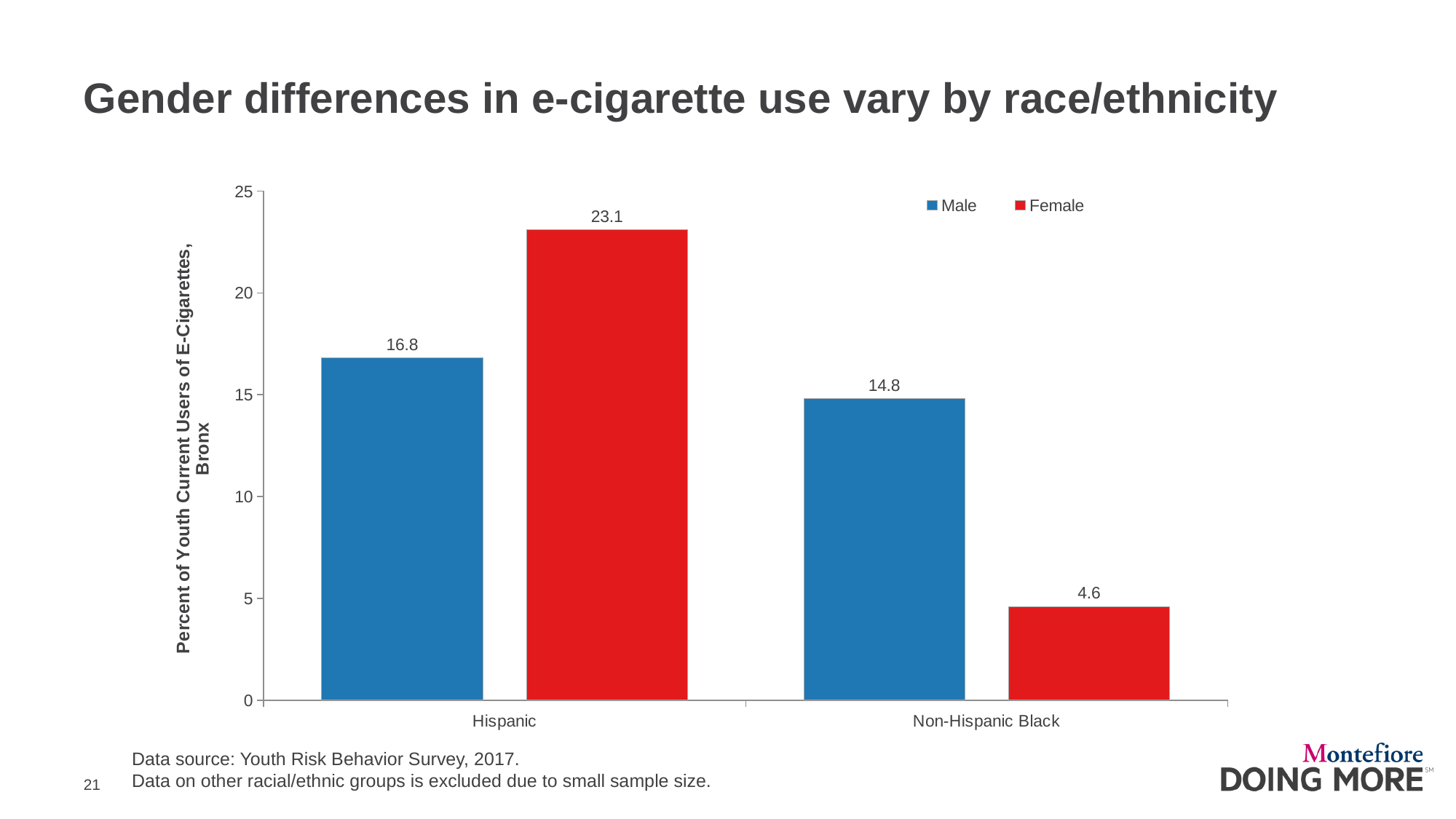
How many series does the legend list? 2 What is the difference between the Female and Male values for Hispanic youth? 6.3 What kind of chart is shown on the slide? Bar chart What is the difference between the Male and Female values for Non-Hispanic Black youth? 10.2 Which is larger, the Male value for Hispanic or the Male value for Non-Hispanic Black? Male value for Hispanic How many race/ethnicity categories are shown on the x axis? 2 Is the Female value for Non-Hispanic Black greater or less than 5? less Which bar has the highest value on the chart? Female, Hispanic What is the value for Female in the Non-Hispanic Black category? 4.6 What is the value for Female in the Hispanic category? 23.1 Which bar has the lowest value on the chart? Female, Non-Hispanic Black What is the value for Male in the Non-Hispanic Black category? 14.8